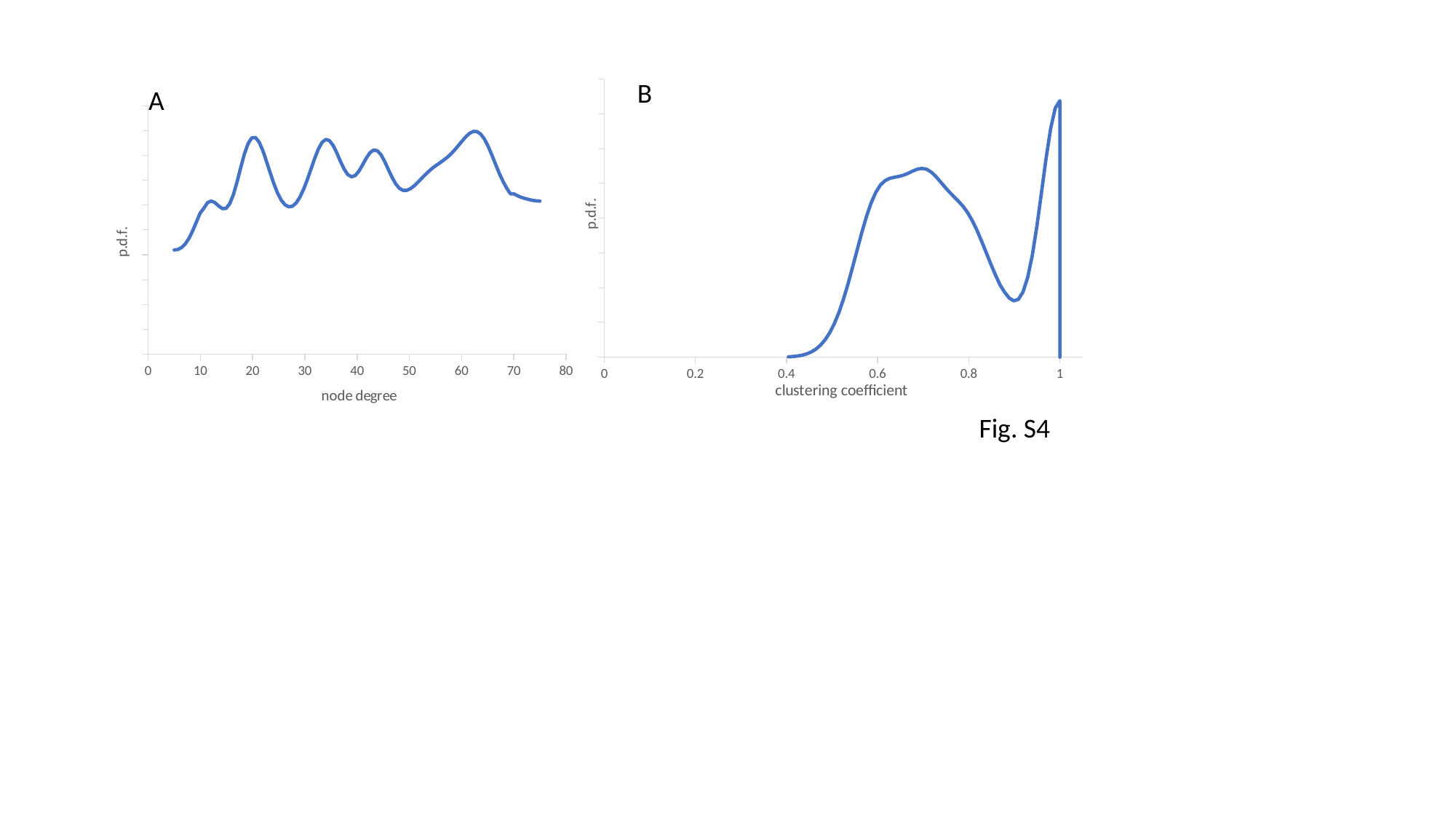
What kind of chart is chart B (the right chart)? line chart In chart B (the right chart), does the curve rise or fall as the clustering coefficient goes from 0.7 to 0.9? fall In chart B (the right chart), at which x-axis tick value does the curve reach its highest point? 1 How many lines are plotted in chart A (the left chart)? 1 How many charts are shown on the slide? 2 In chart A (the left chart), does the curve rise or fall as node degree goes from 5 to 10? rise In chart B (the right chart), does the curve rise or fall as the clustering coefficient goes from 0.4 to 0.6? rise What kind of chart is chart A (the left chart)? line chart What is the x-axis label of chart A (the left chart)? node degree What is the x-axis label of chart B (the right chart)? clustering coefficient What is the largest x-axis tick value shown on chart A (the left chart)? 80